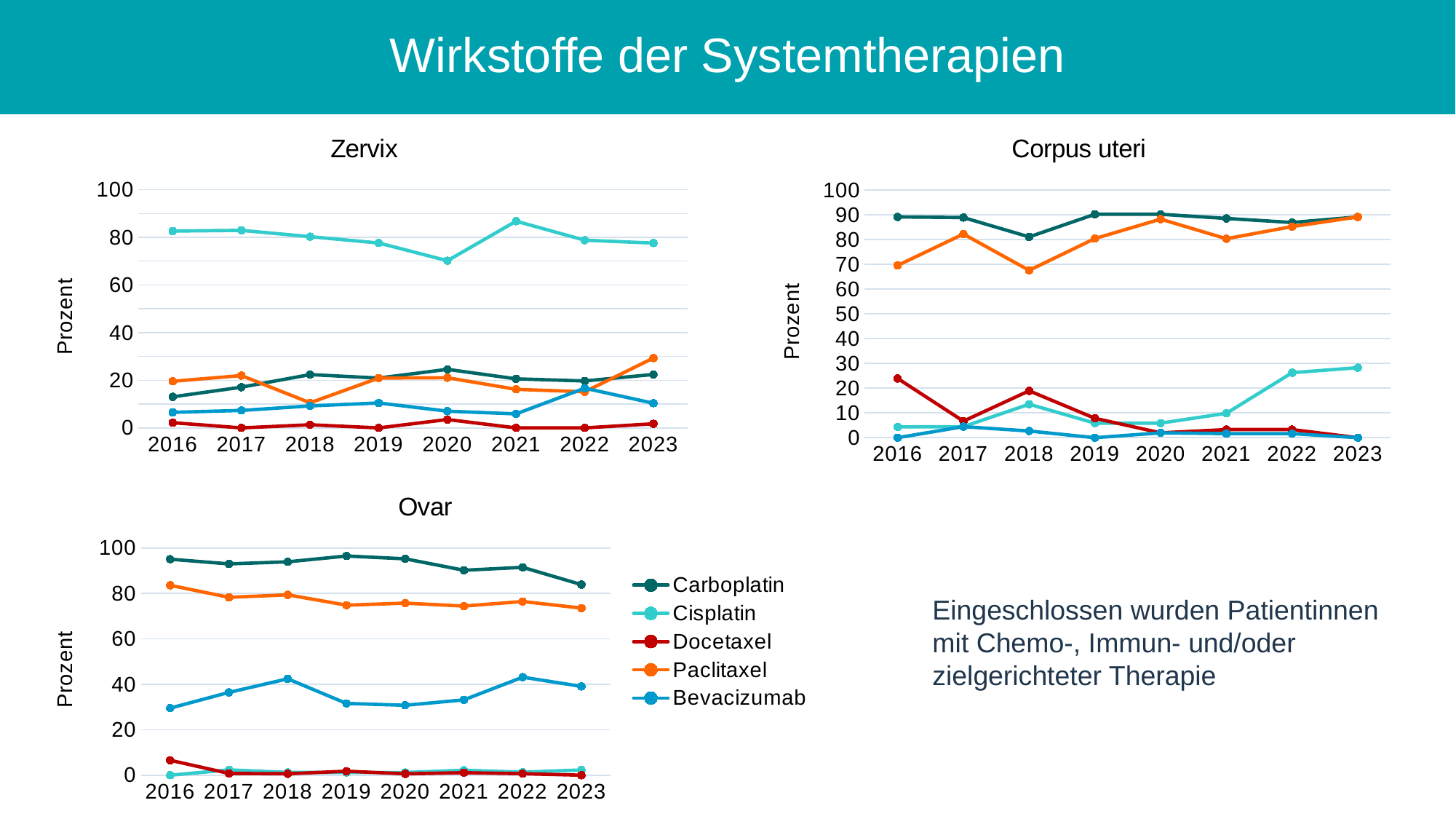
In the Corpus uteri chart, which is larger in 2016, Carboplatin or Paclitaxel? Carboplatin How many series does the legend list? 5 What kind of chart is the Zervix chart? line chart How many years are plotted on the x axis of the Ovar chart? 8 In the Ovar chart, which drug has the highest values across all years? Carboplatin In the Ovar chart, is the value for Bevacizumab in 2022 greater or less than 40? greater In the Zervix chart, is the value for Cisplatin in 2021 greater or less than 80? greater In the Corpus uteri chart, is the value for Paclitaxel in 2018 greater or less than 70? less In the Corpus uteri chart, does the value for Cisplatin rise or fall from 2016 to 2023? rise What is the label on the y axis of the Ovar chart? Prozent In the Zervix chart, which drug has the highest values across all years? Cisplatin